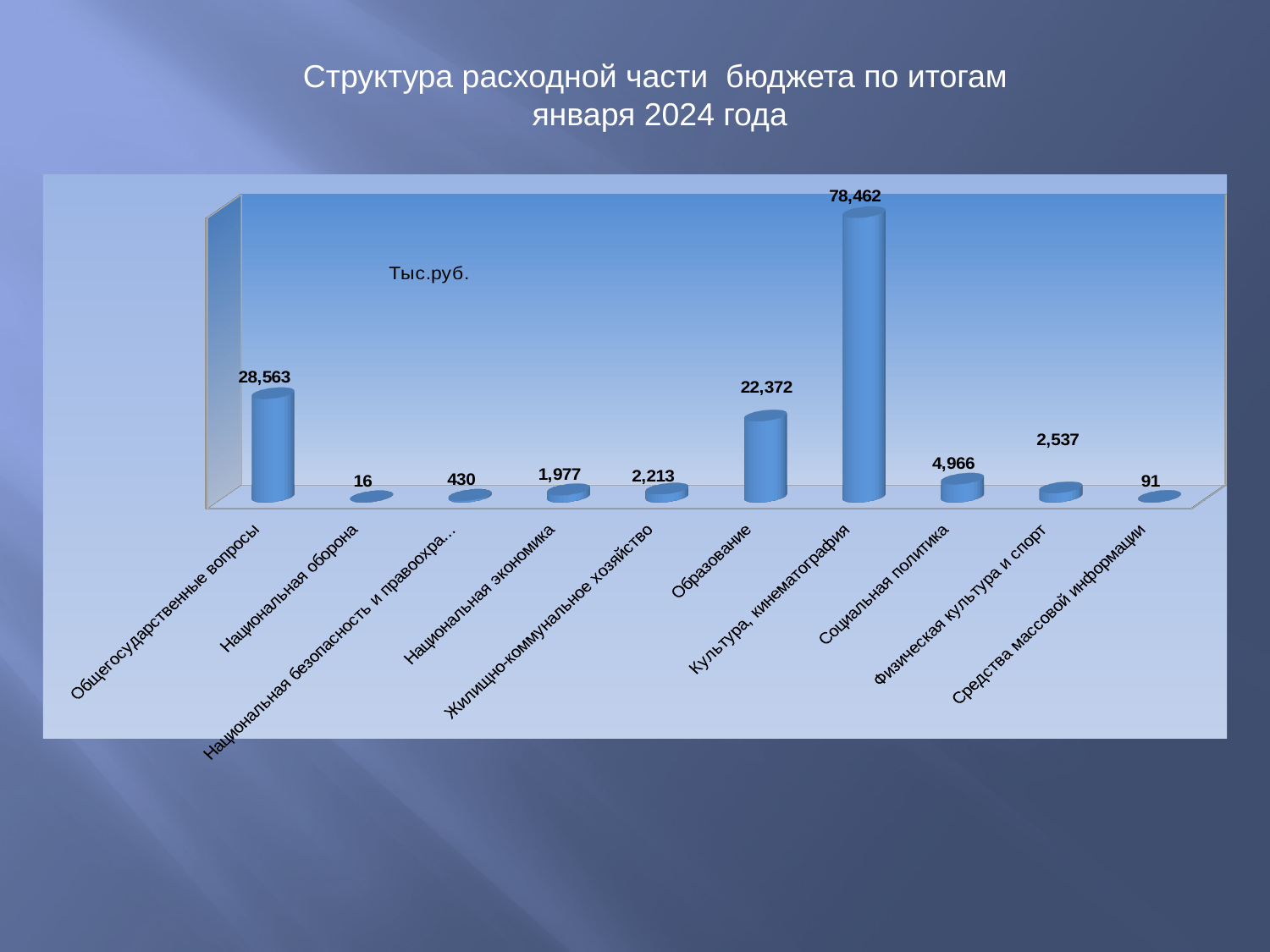
What is the difference between the values for Социальная политика and Физическая культура и спорт? 2,429 What is the value for Средства массовой информации? 91 Which category has the lowest value? Национальная оборона What is the value for Социальная политика? 4,966 Which is larger, the value for Общегосударственные вопросы or the value for Образование? Общегосударственные вопросы How many categories are shown in the chart? 10 What unit is indicated on the chart? Тыс.руб. What is the difference between the values for Культура, кинематография and Общегосударственные вопросы? 49,899 What is the value for Образование? 22,372 What kind of chart is shown on the slide? Bar chart Which is larger, the value for Жилищно-коммунальное хозяйство or the value for Национальная экономика? Жилищно-коммунальное хозяйство Which category has the highest value? Культура, кинематография